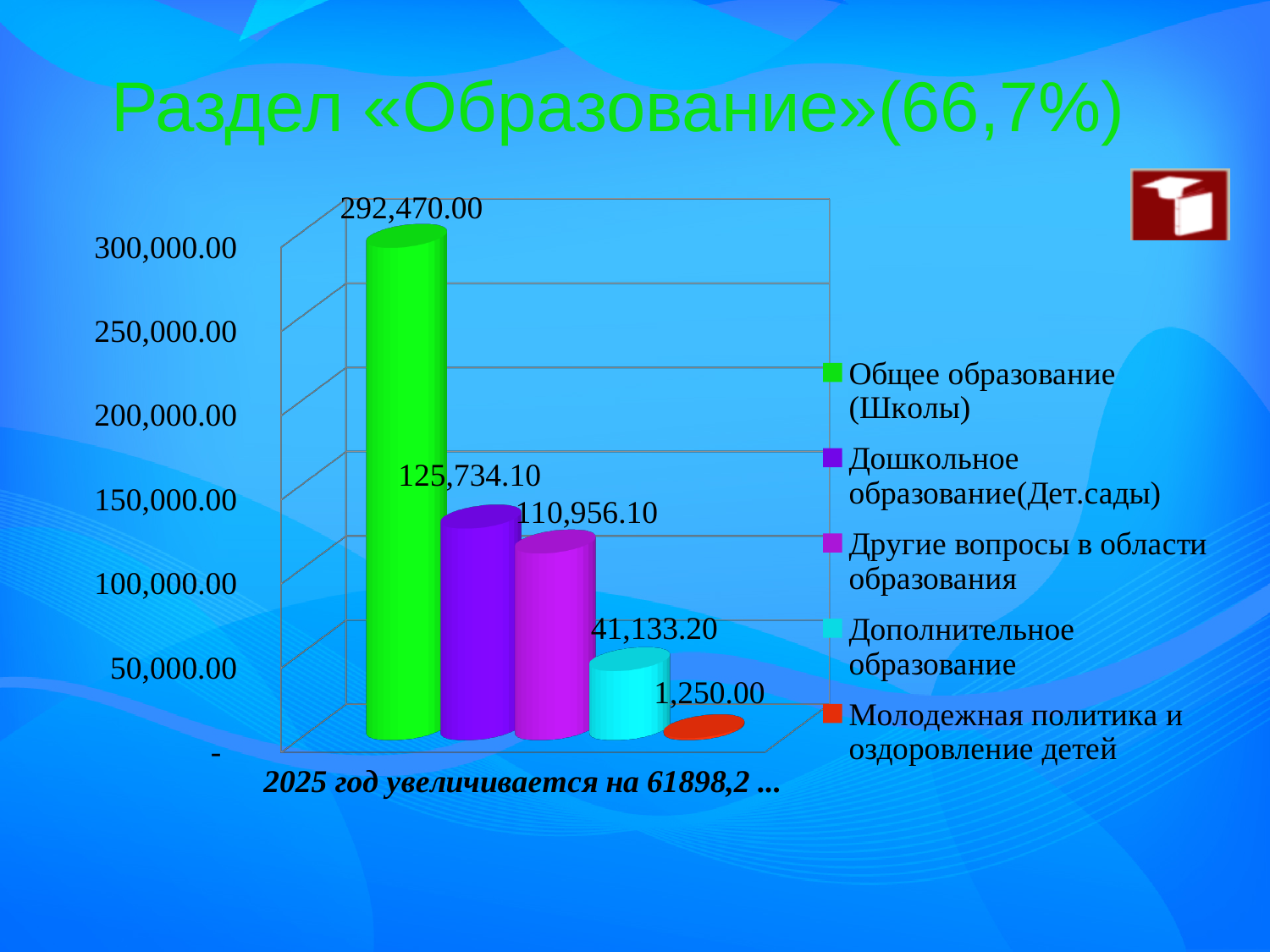
What is the difference between the values for Дошкольное образование(Дет.сады) and Другие вопросы в области образования? 14,778.00 Which series has the highest value? Общее образование (Школы) What is the value for Другие вопросы в области образования? 110,956.10 What is the value for Общее образование (Школы)? 292,470.00 What is the value for Дополнительное образование? 41,133.20 How many series does the legend list? 5 What is the value for Молодежная политика и оздоровление детей? 1,250.00 Which series has the lowest value? Молодежная политика и оздоровление детей Which is larger, the value for Дополнительное образование or the value for Другие вопросы в области образования? Другие вопросы в области образования What kind of chart is shown on the slide? Bar chart What is the value for Дошкольное образование(Дет.сады)? 125,734.10 What is the difference between the values for Общее образование (Школы) and Дошкольное образование(Дет.сады)? 166,735.90